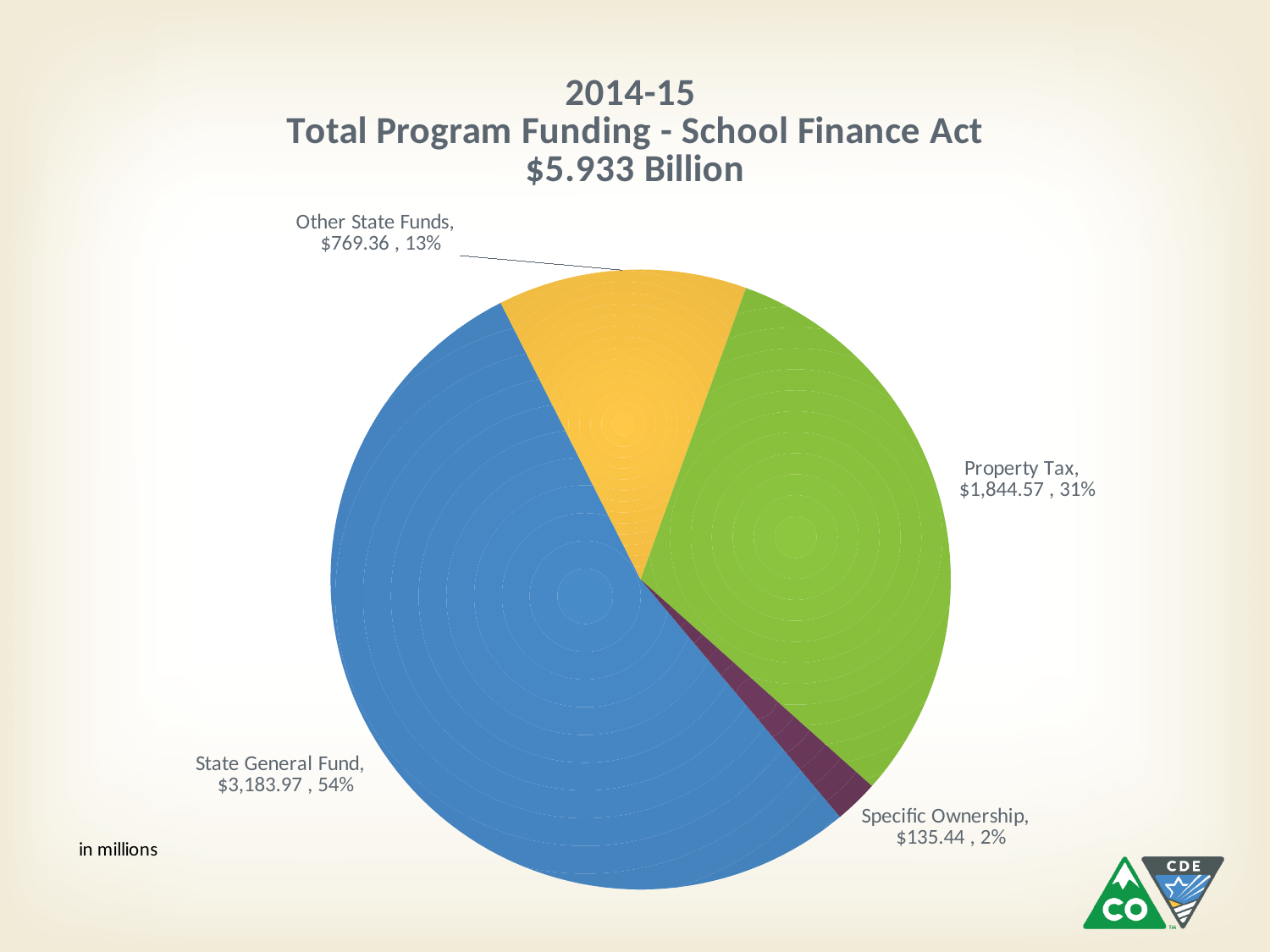
What percentage share of the pie does Other State Funds represent? 13% Which category has the smallest slice of the pie? Specific Ownership What is the value for Property Tax? $1,844.57 What is the difference between the State General Fund value and the Property Tax value? $1,339.40 What is the value for Specific Ownership? $135.44 Which is larger, Other State Funds or Specific Ownership? Other State Funds How many slices does the pie chart have? 4 What total funding amount is stated in the chart title? $5.933 Billion Which category has the largest slice of the pie? State General Fund What percentage share of the pie does Property Tax represent? 31% What is the value for State General Fund? $3,183.97 What kind of chart is shown on the slide? Pie chart